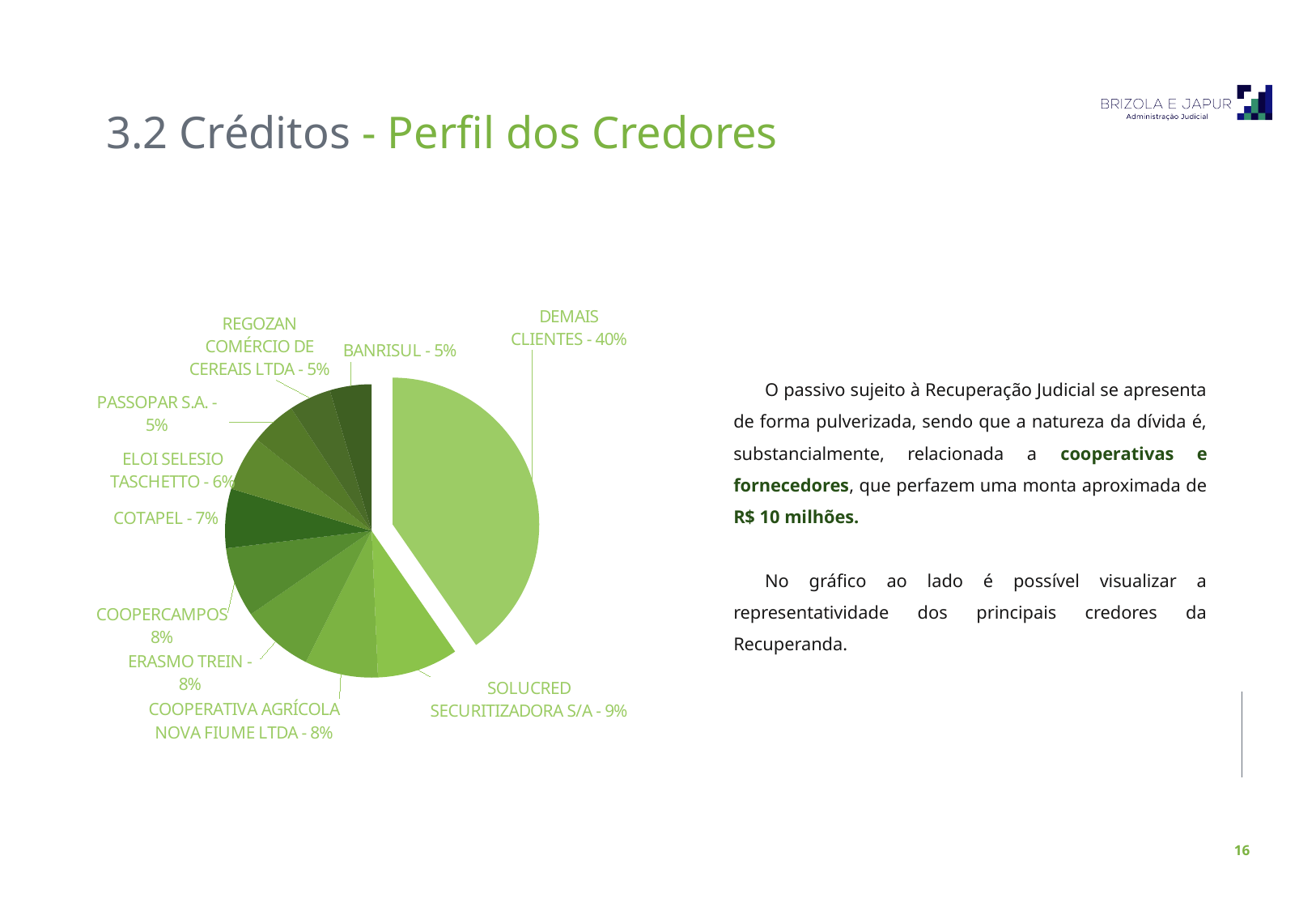
What is the difference in percentage points between COTAPEL and PASSOPAR S.A.? 2 What is the difference in percentage points between DEMAIS CLIENTES and SOLUCRED SECURITIZADORA S/A? 31 How many slices does the pie chart have? 10 What is the value shown for SOLUCRED SECURITIZADORA S/A? 9% What kind of chart is shown on the slide? Pie chart What percentage is shown for ELOI SELESIO TASCHETTO? 6% What percentage is shown for BANRISUL? 5% What share of the pie does DEMAIS CLIENTES represent? 40% Which slice is pulled out (exploded) from the rest of the pie? DEMAIS CLIENTES What percentage is shown for COTAPEL? 7% Which category has the largest slice of the pie? DEMAIS CLIENTES Which is larger, the slice for COOPERCAMPOS or the slice for ELOI SELESIO TASCHETTO? COOPERCAMPOS